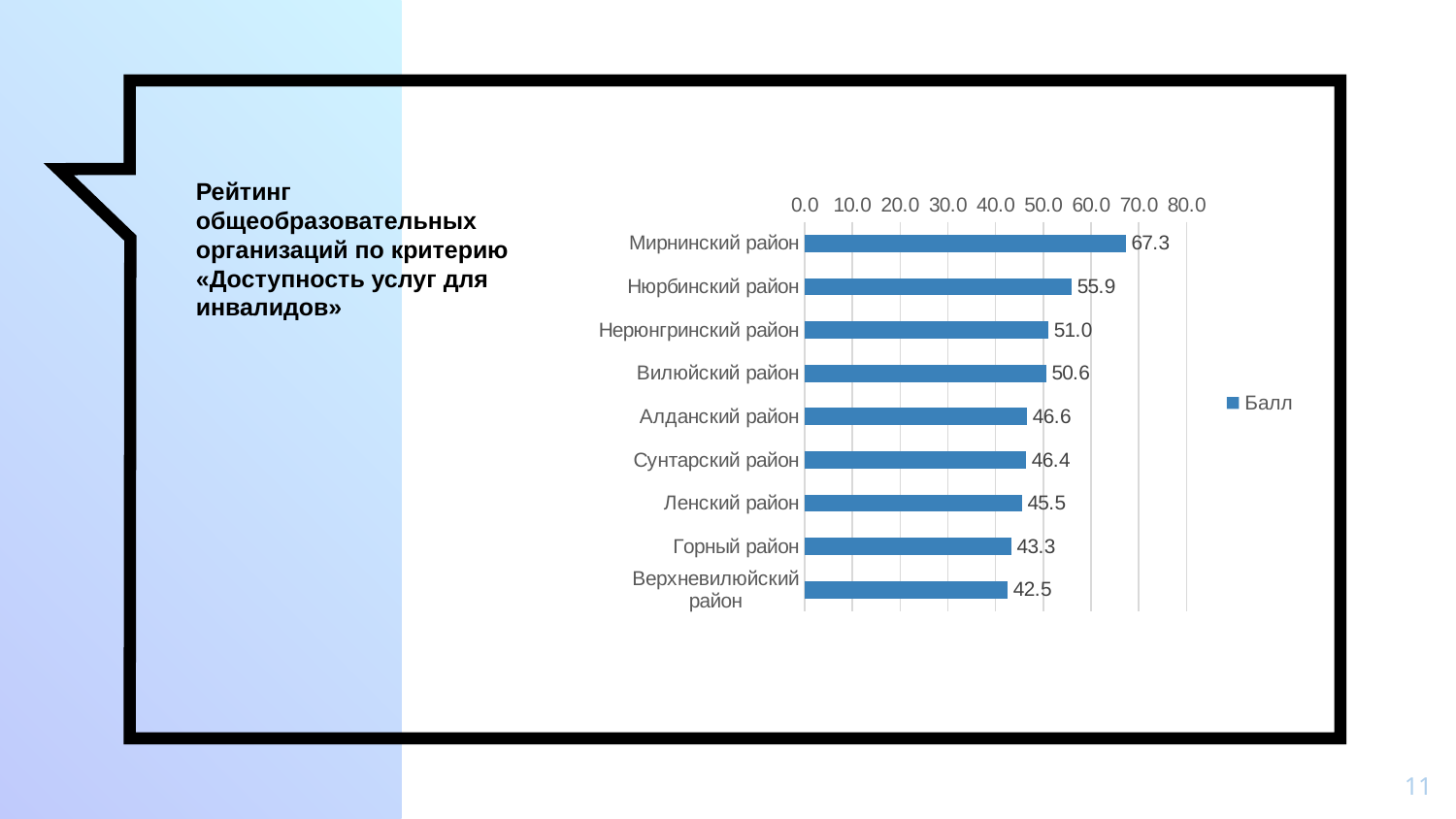
What is the difference between the values for Мирнинский район and Нюрбинский район? 11.4 Which district has the lowest value? Верхневилюйский район How many series does the legend list? 1 What is the value for Вилюйский район? 50.6 What kind of chart is shown on the slide? bar chart Which district has the highest value? Мирнинский район What is the value for Горный район? 43.3 Which is larger, the value for Нерюнгринский район or the value for Алданский район? Нерюнгринский район What is the value for Мирнинский район? 67.3 How many districts are shown in the chart? 9 Is the value for Нюрбинский район greater or less than 50.0? greater What is the difference between the values for Ленский район and Верхневилюйский район? 3.0